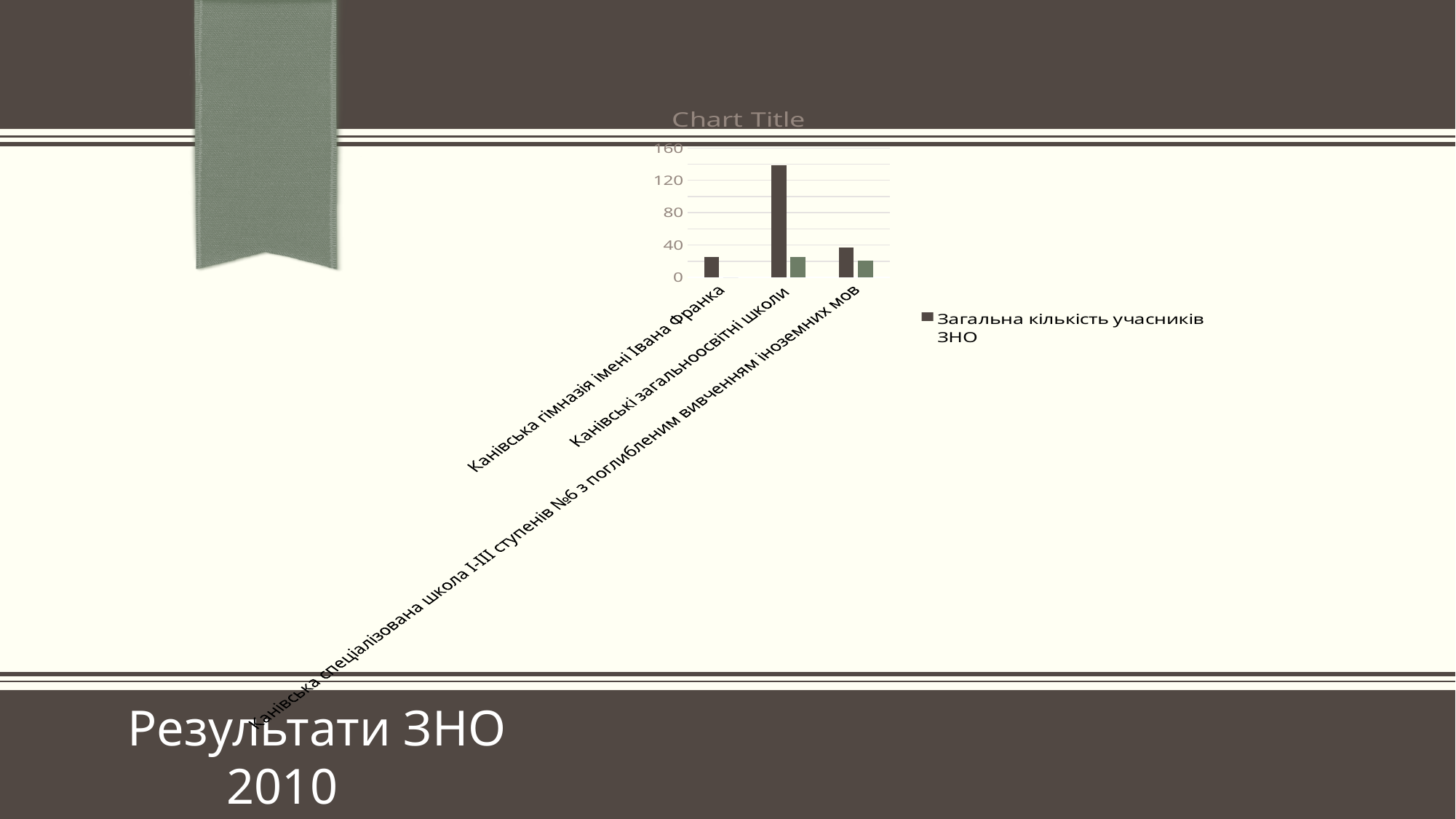
Which has the larger value for Загальна кількість учасників ЗНО: Канівські загальноосвітні школи or Канівська гімназія імені Івана Франка? Канівські загальноосвітні школи Which has the larger value for Загальна кількість учасників ЗНО: Канівська спеціалізована школа I-III ступенів №6 з поглибленим вивченням іноземних мов or Канівська гімназія імені Івана Франка? Канівська спеціалізована школа I-III ступенів №6 з поглибленим вивченням іноземних мов What kind of chart is shown on the slide? bar chart How many categories are shown on the x axis of the chart? 3 What is the title shown above the chart? Chart Title Is the value of Загальна кількість учасників ЗНО for Канівська гімназія імені Івана Франка greater or less than 40? less Is the value of Загальна кількість учасників ЗНО for Канівські загальноосвітні школи greater or less than 120? greater Which category has the highest value for Загальна кількість учасників ЗНО? Канівські загальноосвітні школи Which category has the lowest value for Загальна кількість учасників ЗНО? Канівська гімназія імені Івана Франка Is the value of Загальна кількість учасників ЗНО for Канівська спеціалізована школа I-III ступенів №6 з поглибленим вивченням іноземних мов greater or less than 80? less What is the legend entry shown for the chart? Загальна кількість учасників ЗНО